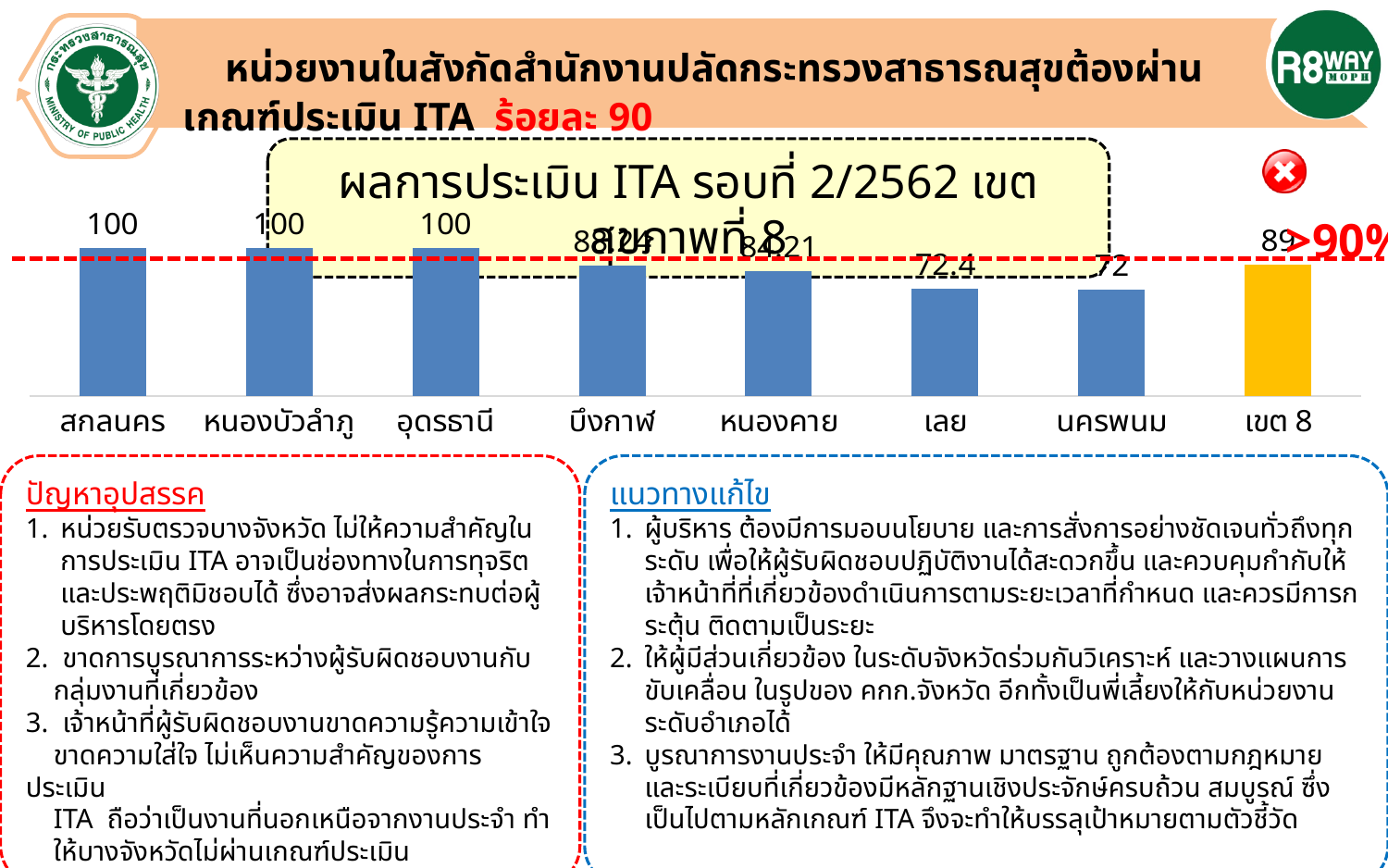
What kind of chart is shown on the slide? bar chart Which category has the lowest value? นครพนม How many categories are shown on the x axis? 8 Which is larger, the value for หนองคาย or the value for เลย? หนองคาย What is the value for หนองคาย? 84.21 What is the difference between the values for หนองคาย and นครพนม? 12.21 What is the value for นครพนม? 72 What is the value for เลย? 72.4 How many categories have a value of 100? 3 Is the value for เขต 8 greater or less than 90? less What is the value for สกลนคร? 100 Which category's bar is coloured orange instead of blue? เขต 8